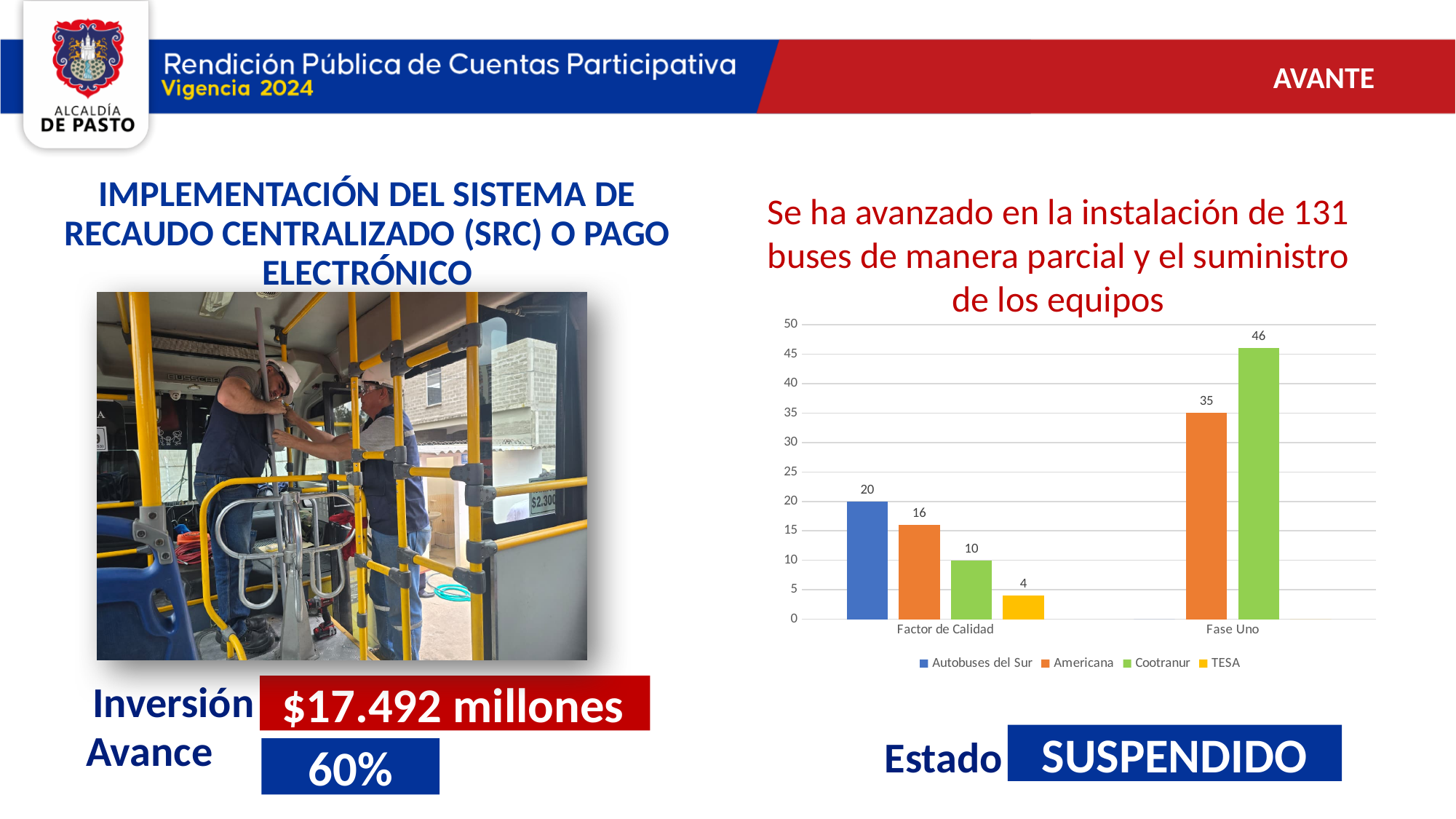
What colour are the Cootranur bars in the chart? green Which series has the lowest value in the Factor de Calidad category? TESA How many series does the chart legend list? 4 What is the value for Autobuses del Sur in the Factor de Calidad category? 20 Which series has the highest value in the Fase Uno category? Cootranur What is the value for Americana in the Fase Uno category? 35 How many categories are shown on the x axis of the chart? 2 What is the value for Cootranur in the Fase Uno category? 46 What is the value for TESA in the Factor de Calidad category? 4 What is the difference between the Cootranur and Americana values in the Fase Uno category? 11 What type of chart is shown on the slide? bar chart Which is larger in the Factor de Calidad category: Americana or Cootranur? Americana